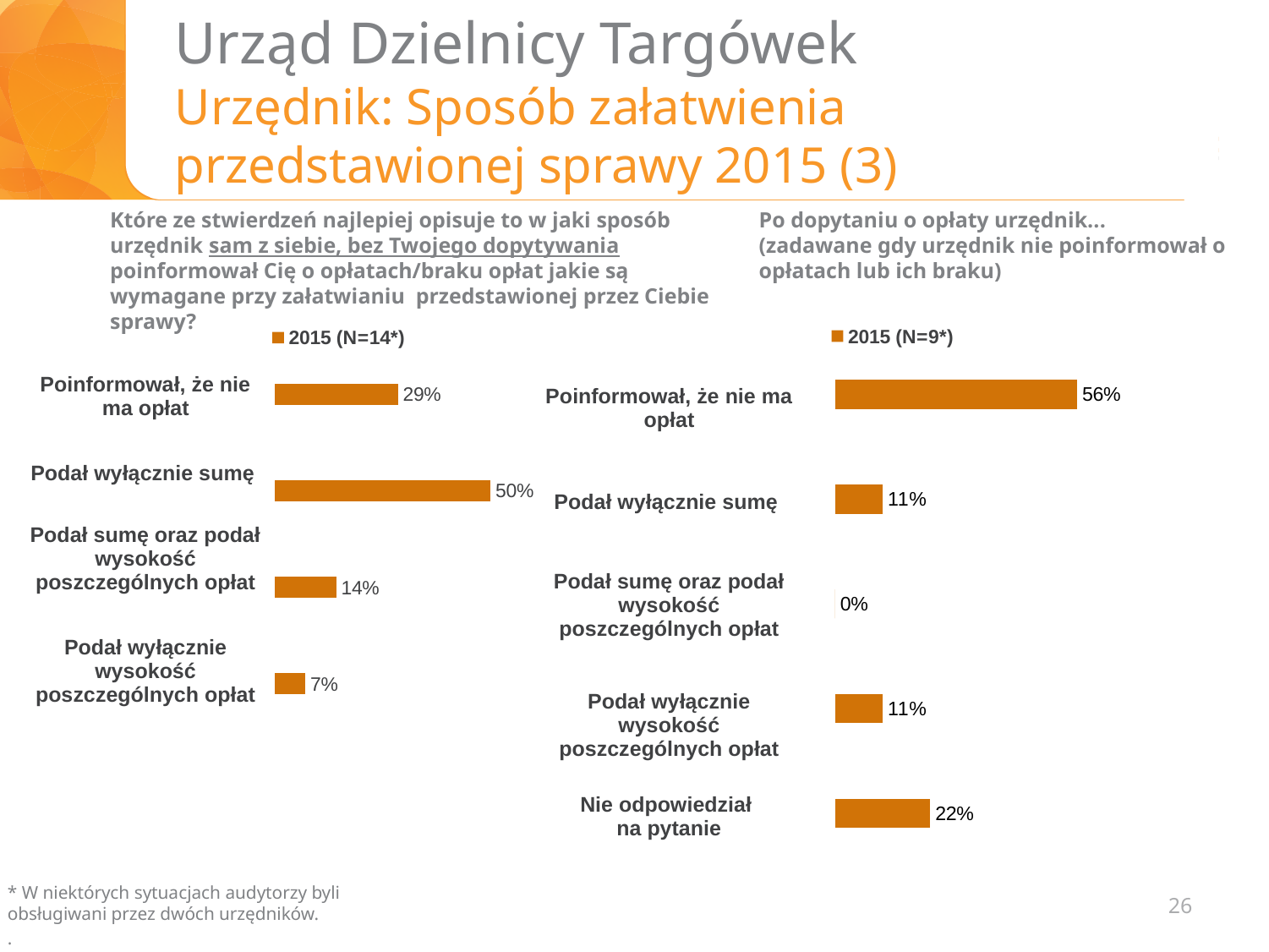
In the left chart (2015, N=14*), which is larger: "Poinformował, że nie ma opłat" or "Podał sumę oraz podał wysokość poszczególnych opłat"? Poinformował, że nie ma opłat In the left chart (2015, N=14*), which category has the highest value? Podał wyłącznie sumę In the right chart (2015, N=9*), what is the value for "Nie odpowiedział na pytanie"? 22% In the right chart (2015, N=9*), what is the difference between "Poinformował, że nie ma opłat" and "Nie odpowiedział na pytanie"? 34 percentage points In the left chart (2015, N=14*), what is the difference between "Podał wyłącznie sumę" and "Poinformował, że nie ma opłat"? 21 percentage points In the left chart (2015, N=14*), what is the value for "Podał wyłącznie sumę"? 50% How many categories are shown in the left chart (2015, N=14*)? 4 In the right chart (2015, N=9*), which category has the lowest value? Podał sumę oraz podał wysokość poszczególnych opłat In the right chart (2015, N=9*), what is the value for "Poinformował, że nie ma opłat"? 56% How many categories are shown in the right chart (2015, N=9*)? 5 In the left chart (2015, N=14*), what is the value for "Podał wyłącznie wysokość poszczególnych opłat"? 7% What type of chart is used on this slide? Bar chart